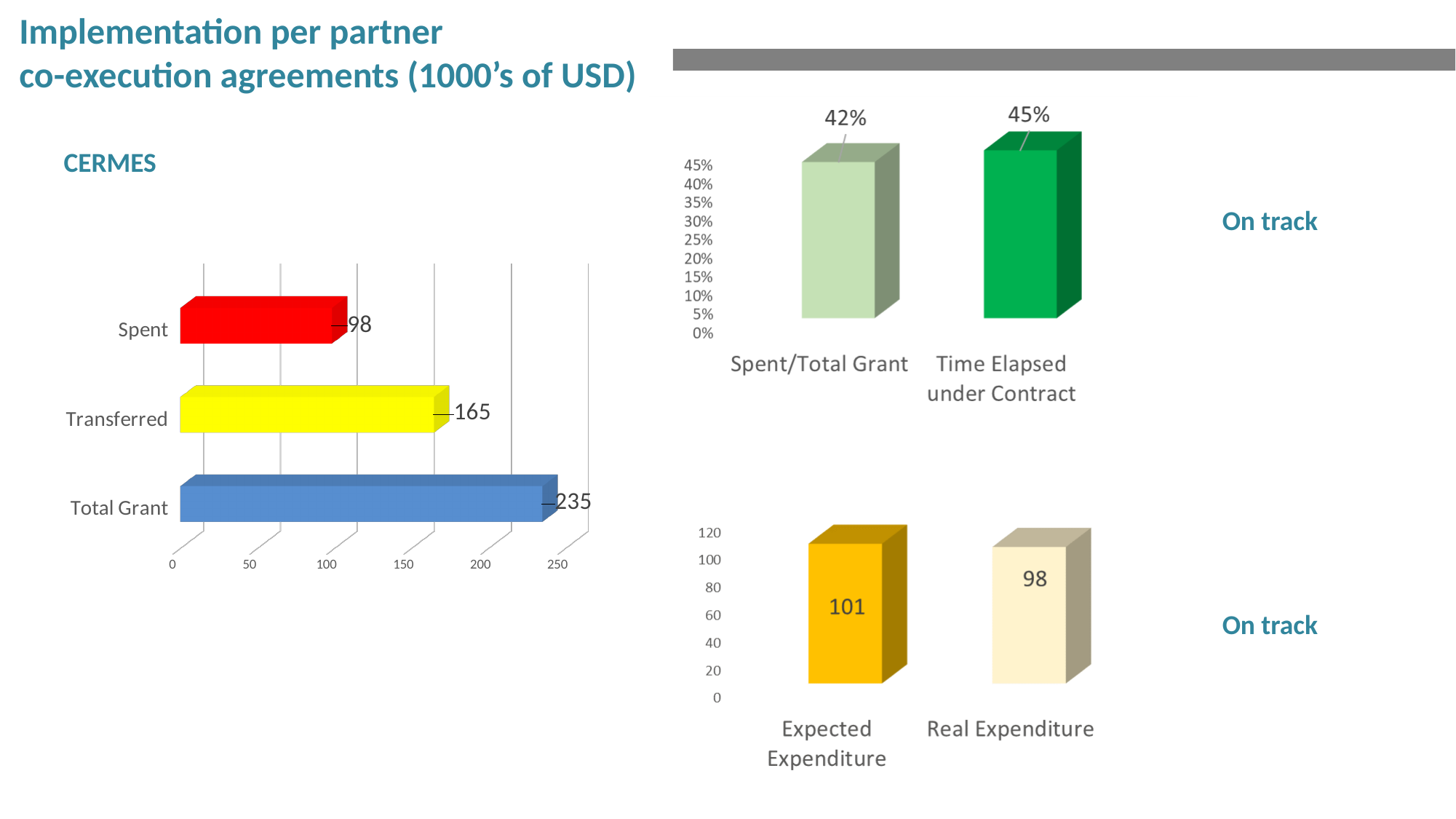
In the CERMES bar chart on the left, what is the value for Spent? 98 In the CERMES bar chart on the left, what is the value for Transferred? 165 In the CERMES bar chart on the left, what is the value for Total Grant? 235 What kind of chart is the CERMES chart on the left? Bar chart In the top-right chart, what is the value for Time Elapsed under Contract? 45% In the top-right chart, what is the value for Spent/Total Grant? 42% In the CERMES bar chart on the left, how many categories are shown? 3 In the bottom-right chart, which is larger, Expected Expenditure or Real Expenditure? Expected Expenditure In the CERMES bar chart on the left, which category has the lowest value? Spent In the CERMES bar chart on the left, which category has the highest value? Total Grant In the bottom-right chart, what is the value for Expected Expenditure? 101 In the CERMES bar chart on the left, what is the difference between Total Grant and Transferred? 70